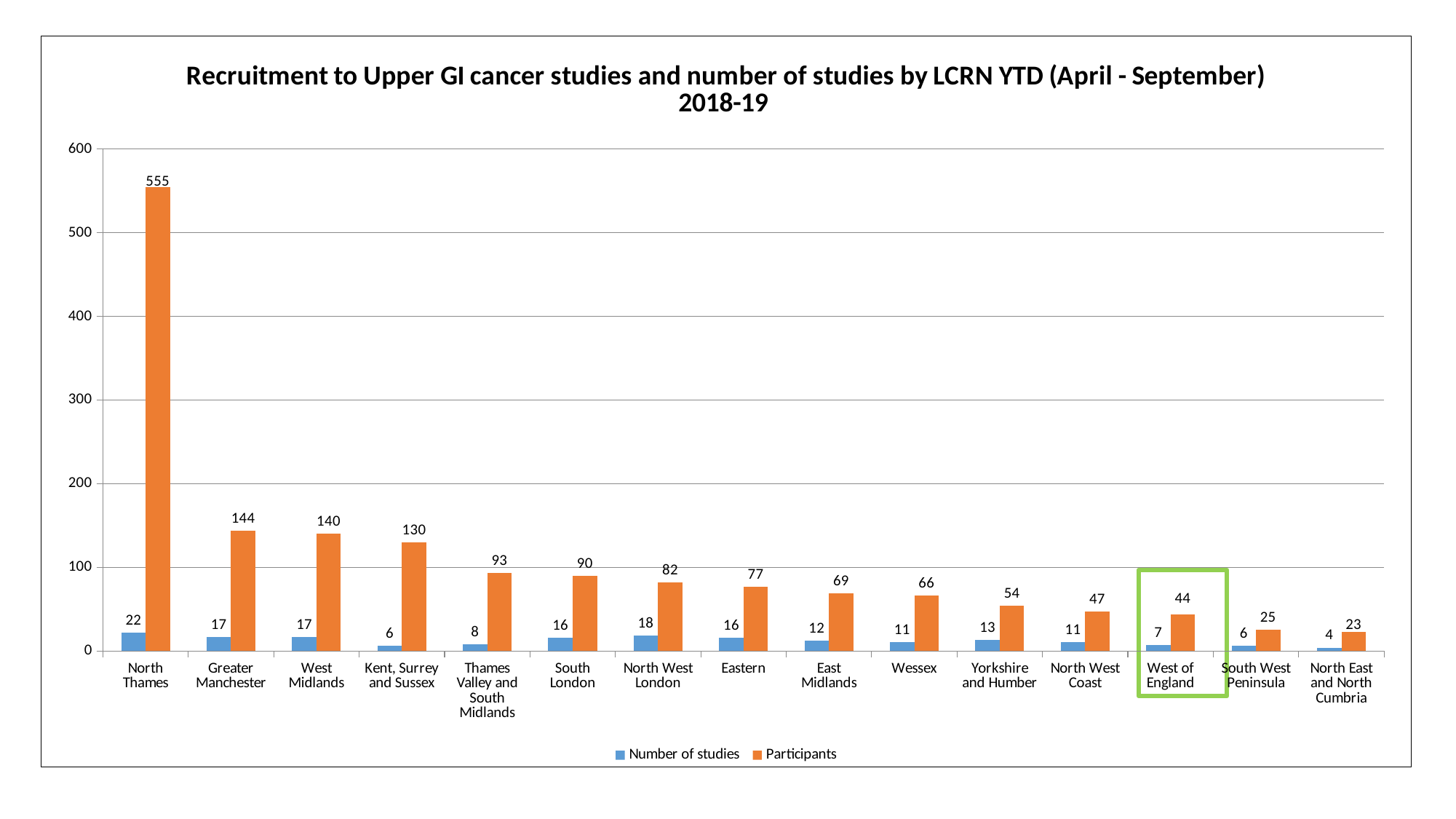
How many Participants were recruited in North Thames? 555 Which LCRN has the highest number of Participants? North Thames Which LCRN is highlighted with a green box on the chart? West of England Which LCRN has the lowest Number of studies? North East and North Cumbria Is the Participants value for Kent, Surrey and Sussex greater or less than 100? greater How many Participants were recruited in Yorkshire and Humber? 54 Which has more Participants, South London or North West London? South London What kind of chart is shown on the slide? bar chart How many series does the legend list? 2 How many LCRNs are shown on the x axis? 15 What is the Number of studies for West of England? 7 What is the difference in Participants between Greater Manchester and West Midlands? 4